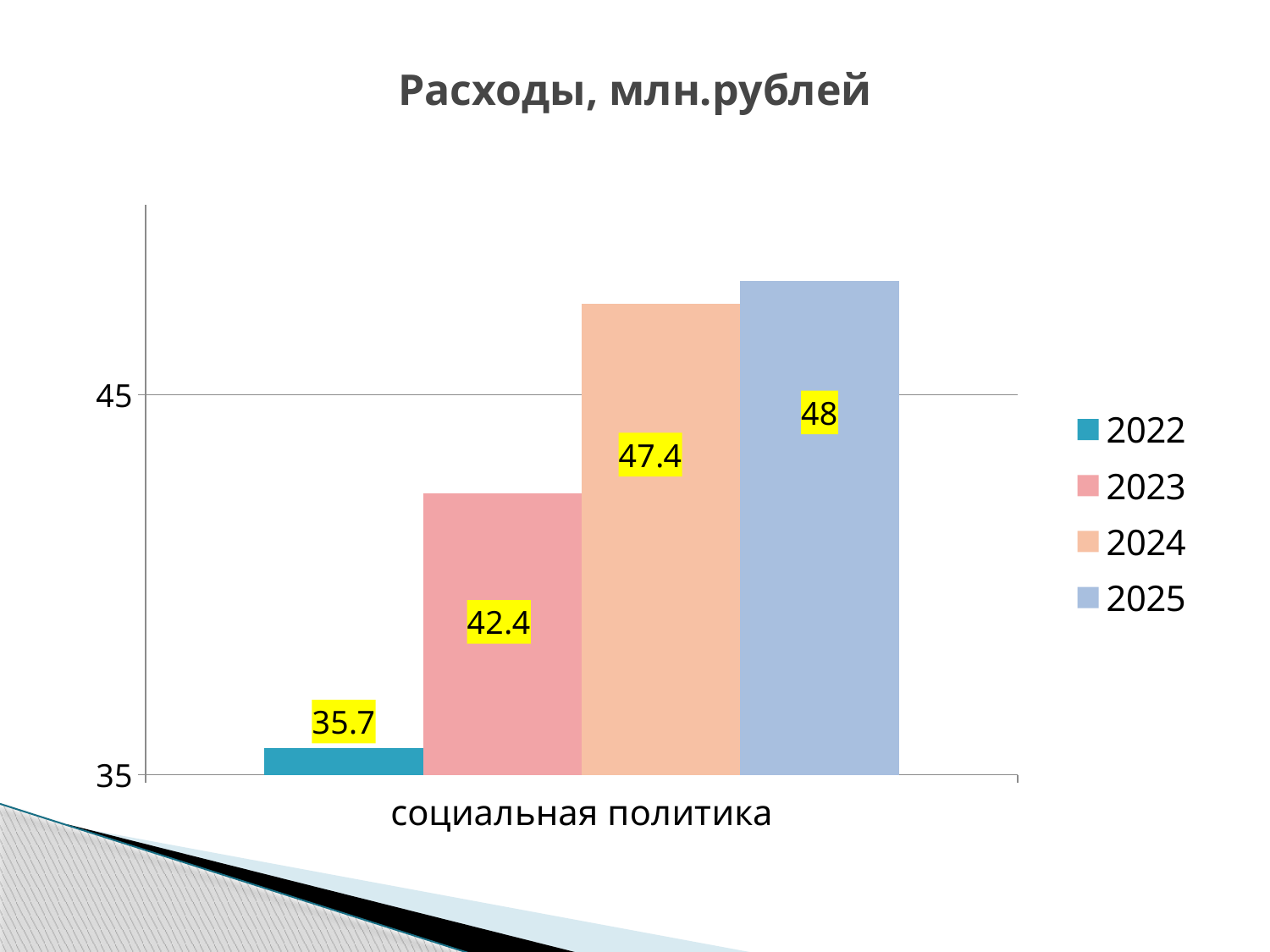
Is the value for 2023 greater or less than 45? less What is the value for 2022 in the chart? 35.7 What is the value for 2025 in the chart? 48 What kind of chart is shown on the slide? bar chart What is the difference between the values for 2023 and 2022? 6.7 Which year has the highest value? 2025 Which year has the lowest value? 2022 What is the value for 2024 in the chart? 47.4 What is the difference between the values for 2025 and 2022? 12.3 What is the value for 2023 in the chart? 42.4 Which is larger, the value for 2023 or the value for 2024? 2024 How many series does the legend list? 4